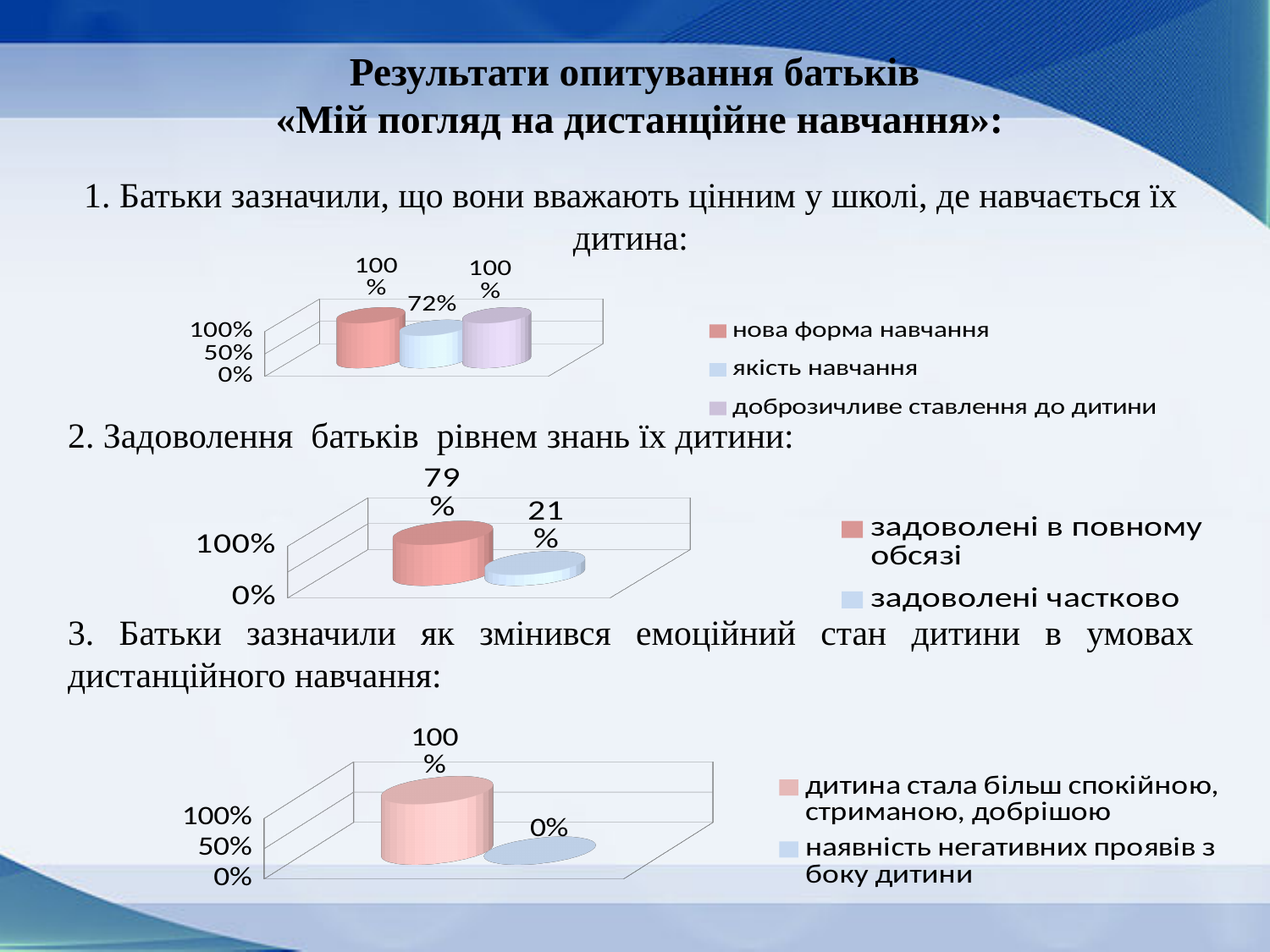
In the top chart (item 1), which series has the lowest value? якість навчання In the middle chart (item 2), which series has the higher value: «задоволені в повному обсязі» or «задоволені частково»? задоволені в повному обсязі In the middle chart (item 2), what is the value for «задоволені в повному обсязі»? 79% In the top chart (item 1), what is the difference between the value for «нова форма навчання» and the value for «якість навчання»? 28% In the bottom chart (item 3), what is the value for «наявність негативних проявів з боку дитини»? 0% In the top chart (item 1), what is the value for «нова форма навчання»? 100% In the top chart (item 1), how many series does the legend list? 3 What kind of chart is the bottom chart (item 3)? bar chart In the top chart (item 1), what is the value for «якість навчання»? 72% In the bottom chart (item 3), what is the value for «дитина стала більш спокійною, стриманою, добрішою»? 100% In the middle chart (item 2), what is the value for «задоволені частково»? 21% In the middle chart (item 2), what is the difference between the two plotted values? 58%